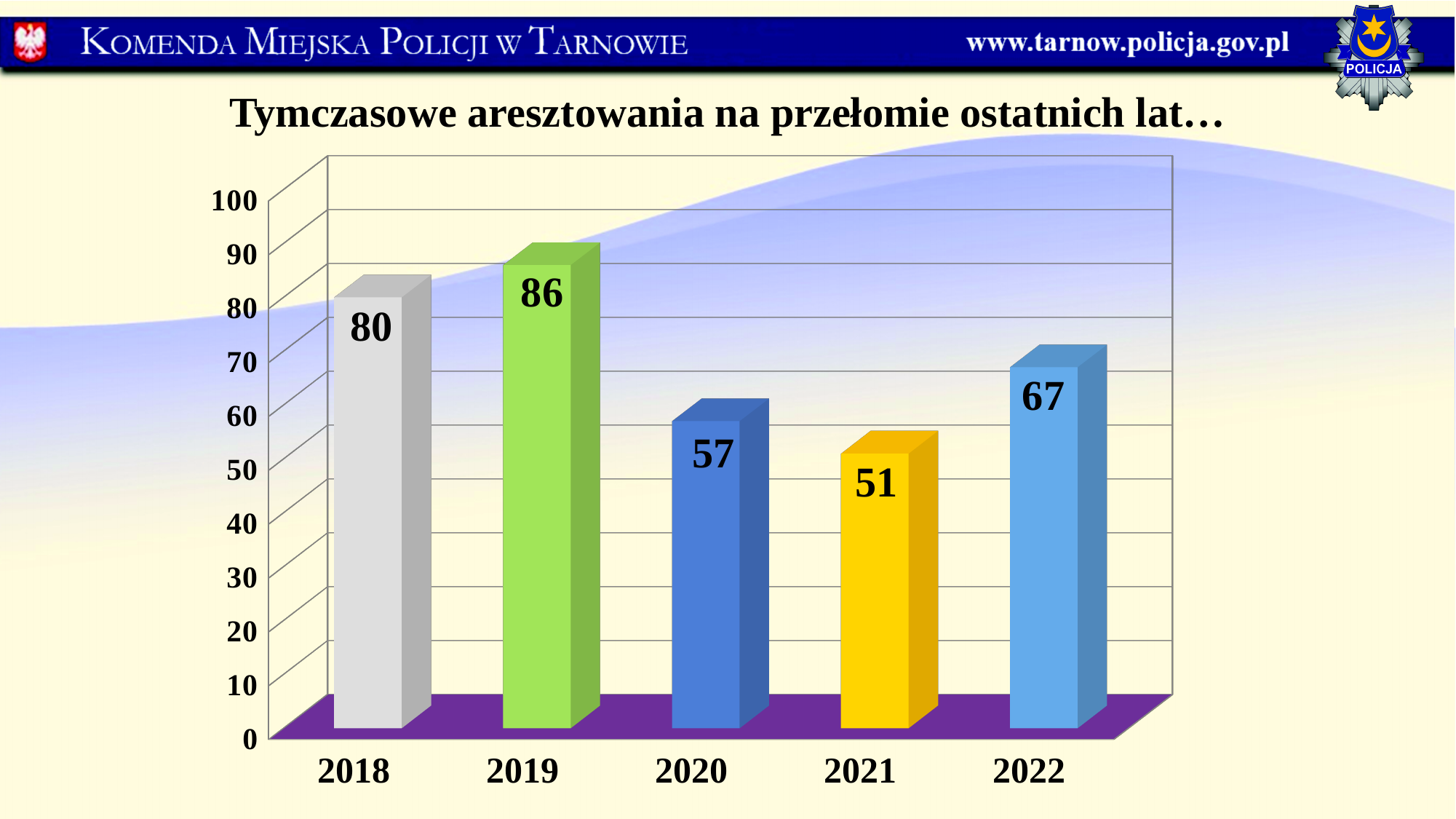
What kind of chart is shown on the slide? bar chart What is the difference between the values for 2022 and 2021? 16 Is the value for 2020 greater or less than 60? less What is the value for 2021? 51 Which year has the highest value? 2019 Which year has the lowest value? 2021 Which is larger, the value for 2020 or the value for 2022? 2022 How many years are shown on the x axis? 5 What is the value for 2022? 67 What is the title of the chart? Tymczasowe aresztowania na przełomie ostatnich lat… What is the difference between the values for 2019 and 2018? 6 What is the value for 2018? 80